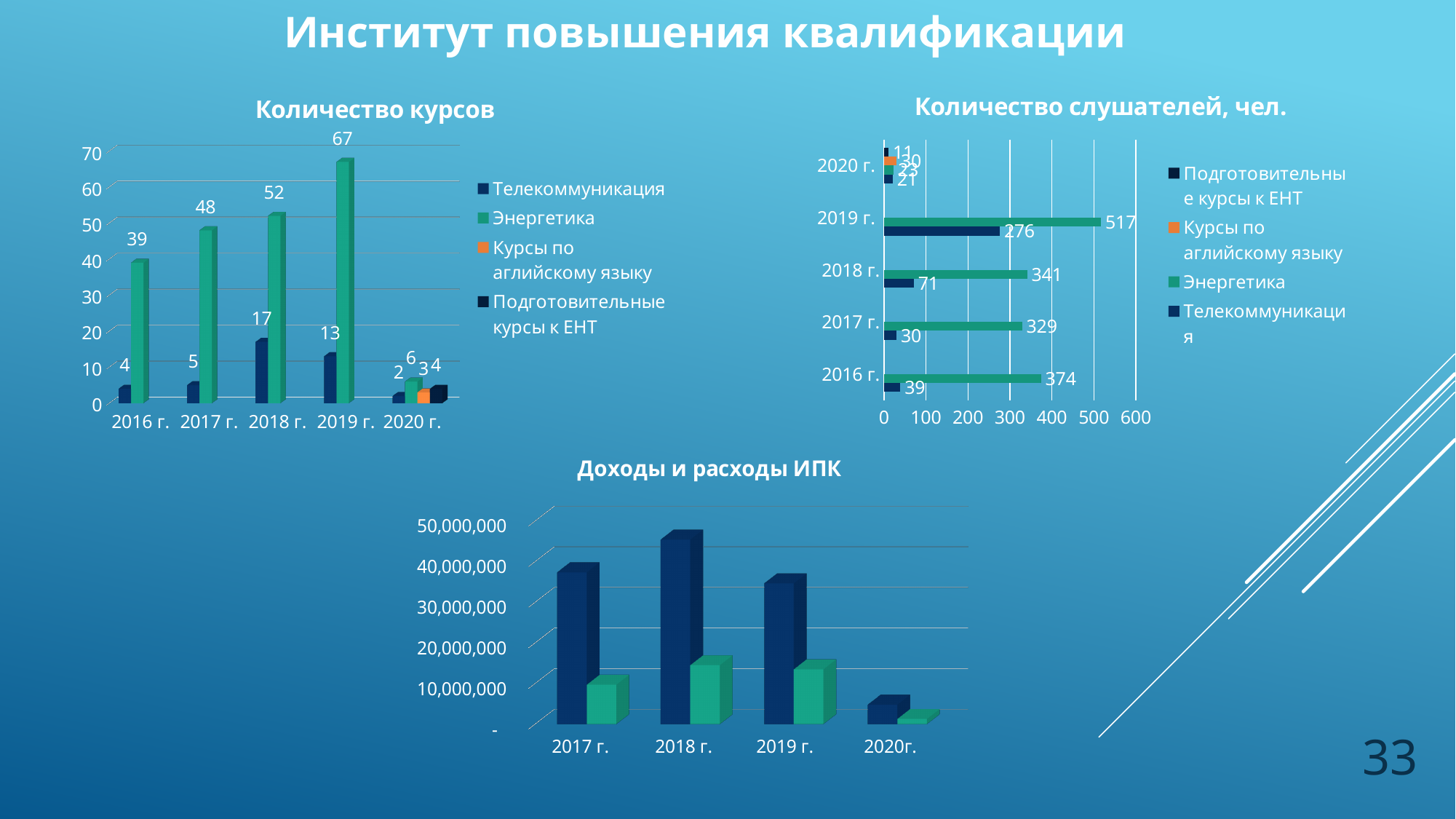
In the chart titled "Количество слушателей, чел.", which year has the lowest Телекоммуникация value? 2020 г. In the chart titled "Количество курсов", how many series does the legend list? 4 In the chart titled "Количество слушателей, чел.", which is larger: the Энергетика value in 2016 г. or in 2017 г.? 2016 г. In the chart titled "Количество слушателей, чел.", what is the value for Телекоммуникация in 2018 г.? 71 In the chart titled "Количество слушателей, чел.", how many year categories are shown on the vertical axis? 5 In the chart titled "Количество курсов", what is the difference between the Энергетика and Телекоммуникация values in 2018 г.? 35 What kind of chart is the one titled "Доходы и расходы ИПК"? Bar chart In the chart titled "Количество слушателей, чел.", what is the value for Энергетика in 2019 г.? 517 In the chart titled "Количество курсов", what is the value for Энергетика in 2019 г.? 67 In the chart titled "Количество курсов", which year has the highest value for Энергетика? 2019 г. In the chart titled "Доходы и расходы ИПК", is the value of the dark blue bar for 2018 г. greater or less than 40,000,000? greater